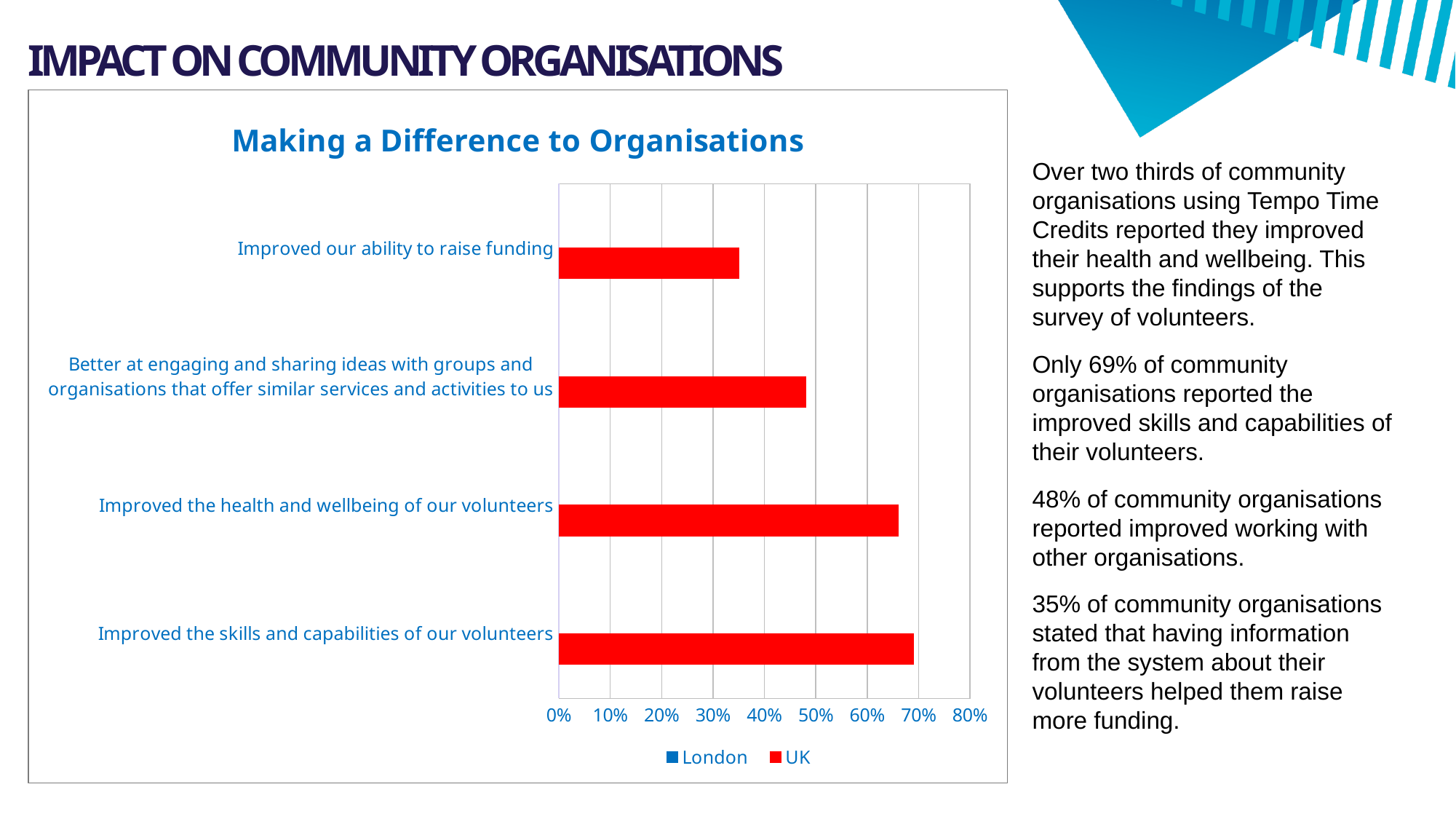
What is the title of the chart? Making a Difference to Organisations What colour are the UK bars in the chart? red Which is larger: the value for 'Improved our ability to raise funding' or the value for 'Improved the skills and capabilities of our volunteers'? Improved the skills and capabilities of our volunteers Is the value for 'Improved the health and wellbeing of our volunteers' greater or less than 60%? greater Which category has the shortest bar in the chart? Improved our ability to raise funding How many categories are plotted in the chart? 4 Which category has the longest bar in the chart? Improved the skills and capabilities of our volunteers How many series does the chart legend list? 2 What kind of chart is shown on the slide? bar chart Is the value for 'Improved our ability to raise funding' greater or less than 40%? less Is the value for 'Better at engaging and sharing ideas with groups and organisations that offer similar services and activities to us' greater or less than 40%? greater Which is larger: the value for 'Improved the health and wellbeing of our volunteers' or the value for 'Better at engaging and sharing ideas with groups and organisations that offer similar services and activities to us'? Improved the health and wellbeing of our volunteers